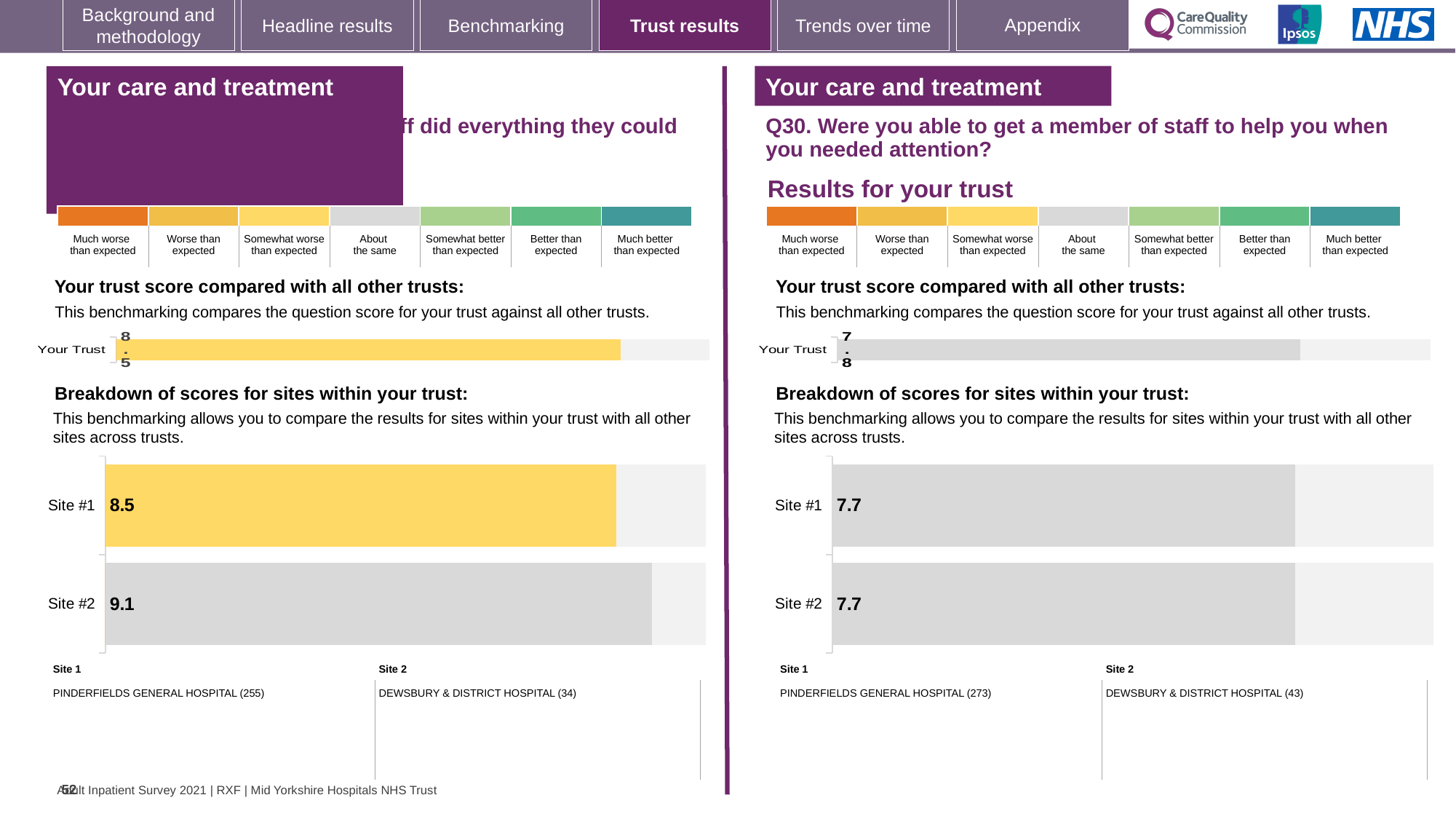
What type of chart is used for the breakdown of scores for sites within your trust on the left-hand side of the slide? Bar chart On the left-hand side of the slide, what is the score shown for Site #2 in the breakdown of scores for sites within your trust? 9.1 On the left-hand side of the slide, what is the score shown for Site #1 in the breakdown of scores for sites within your trust? 8.5 In the Q30 chart on the right-hand side of the slide, what is the score shown for Site #1? 7.7 On the left-hand side of the slide, which site has the higher score in the breakdown of scores for sites within your trust? Site #2 On the left-hand side of the slide, what is the difference between the Site #2 score and the Site #1 score? 0.6 In the Q30 chart on the right-hand side of the slide, how many sites are shown in the breakdown of scores for sites within your trust? 2 In the Q30 chart on the right-hand side of the slide, what is the 'Your Trust' score in the trust score comparison chart? 7.8 On the left-hand side of the slide, what is the 'Your Trust' score in the trust score comparison chart? 8.5 In the Q30 chart on the right-hand side of the slide, which hospital is listed as Site 2? DEWSBURY & DISTRICT HOSPITAL (43) In the Q30 chart on the right-hand side of the slide, what is the difference between the Site #1 and Site #2 scores? 0 On the left-hand side of the slide, what colour is the bar for Site #1 in the breakdown of scores for sites within your trust? Yellow